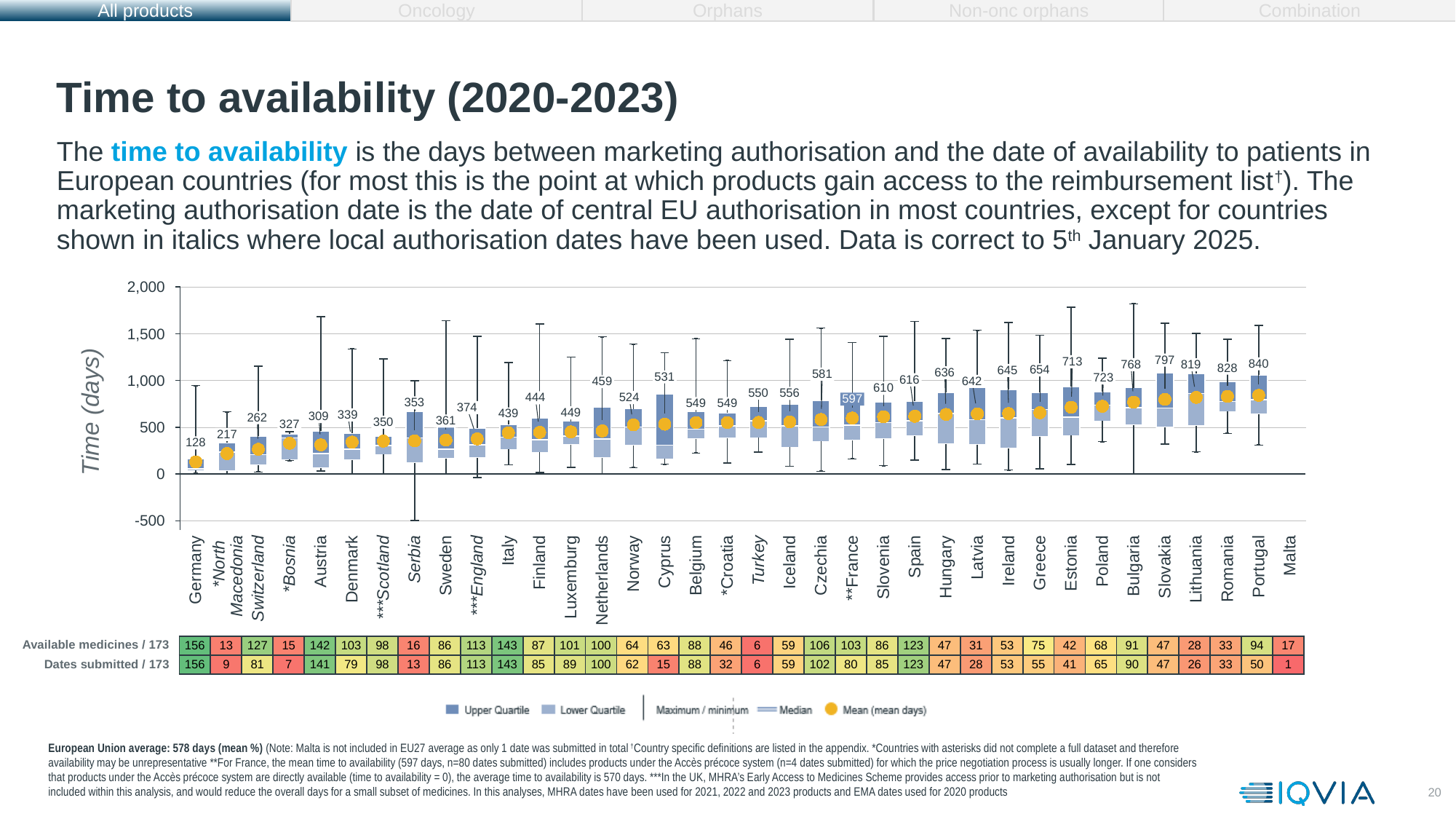
How many entries does the chart legend list? 5 What is the mean time to availability (days) shown for Germany? 128 What is the mean time to availability (days) shown for Portugal? 840 How many countries are listed along the x axis of the chart? 36 Which has a higher mean time to availability, Poland or Estonia? Poland What is the title of the y axis of the chart? Time (days) Do the labelled mean values generally rise or fall moving from left to right along the x axis? rise What is the difference between the mean time to availability for Portugal and for Germany? 712 Which country has the lowest labelled mean time to availability? Germany What is the mean time to availability (days) shown for **France? 597 What is the mean time to availability (days) shown for Netherlands? 459 Which country has the highest labelled mean time to availability? Portugal